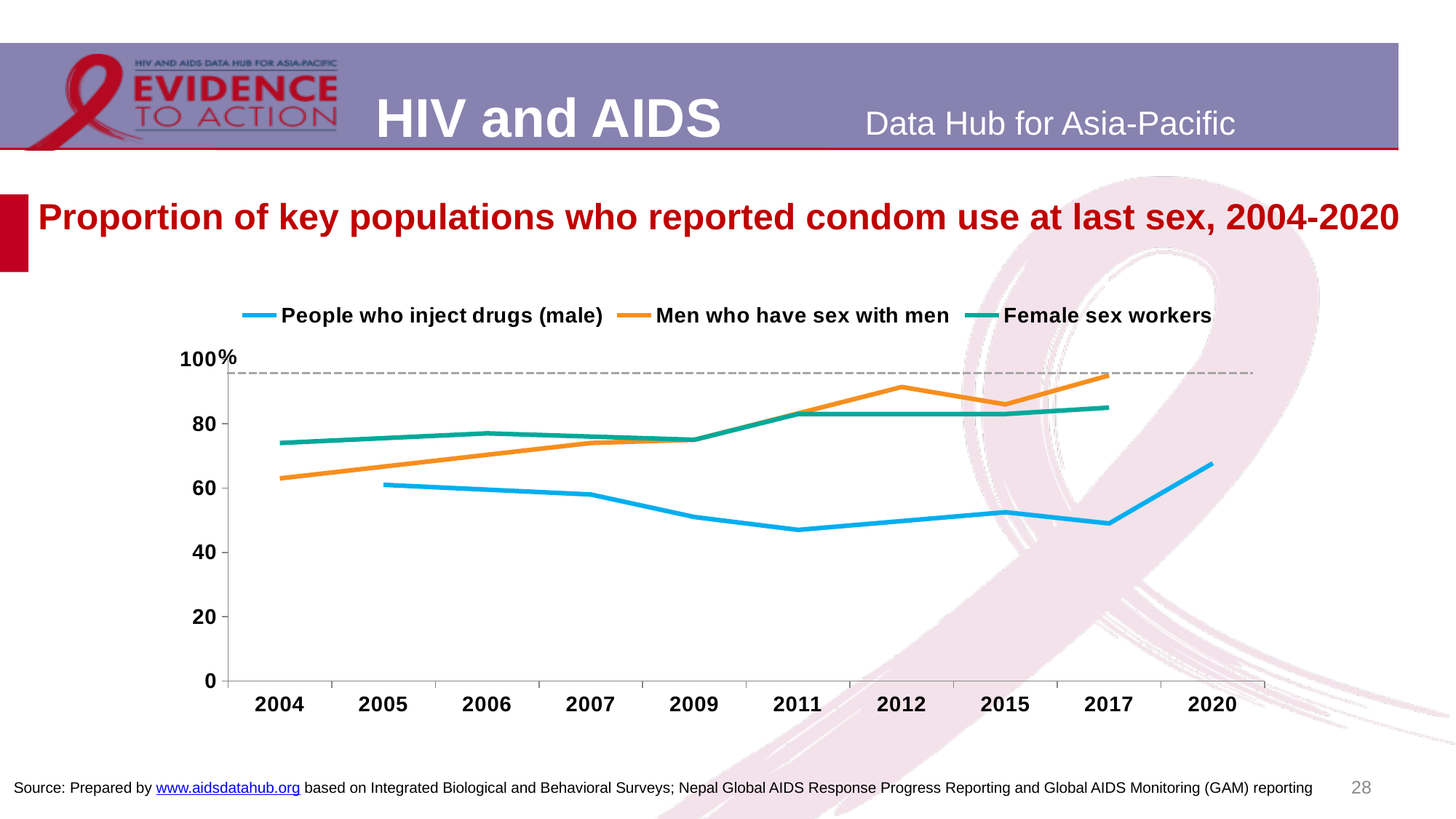
Is the value for People who inject drugs (male) in 2011 greater or less than 60? less In which year is the value for Men who have sex with men highest? 2017 What kind of chart is shown on the slide? line chart In 2012, which is higher: Men who have sex with men or Female sex workers? Men who have sex with men How many series does the legend list? 3 Which series is drawn in blue? People who inject drugs (male) Does the Men who have sex with men line rise or fall from 2004 to 2012? rise In 2004, which is higher: Men who have sex with men or Female sex workers? Female sex workers How many years are shown on the x axis? 10 Is the value for Men who have sex with men in 2017 greater or less than 80? greater Is the value for Female sex workers in 2004 greater or less than 60? greater In which year is the value for People who inject drugs (male) lowest? 2011